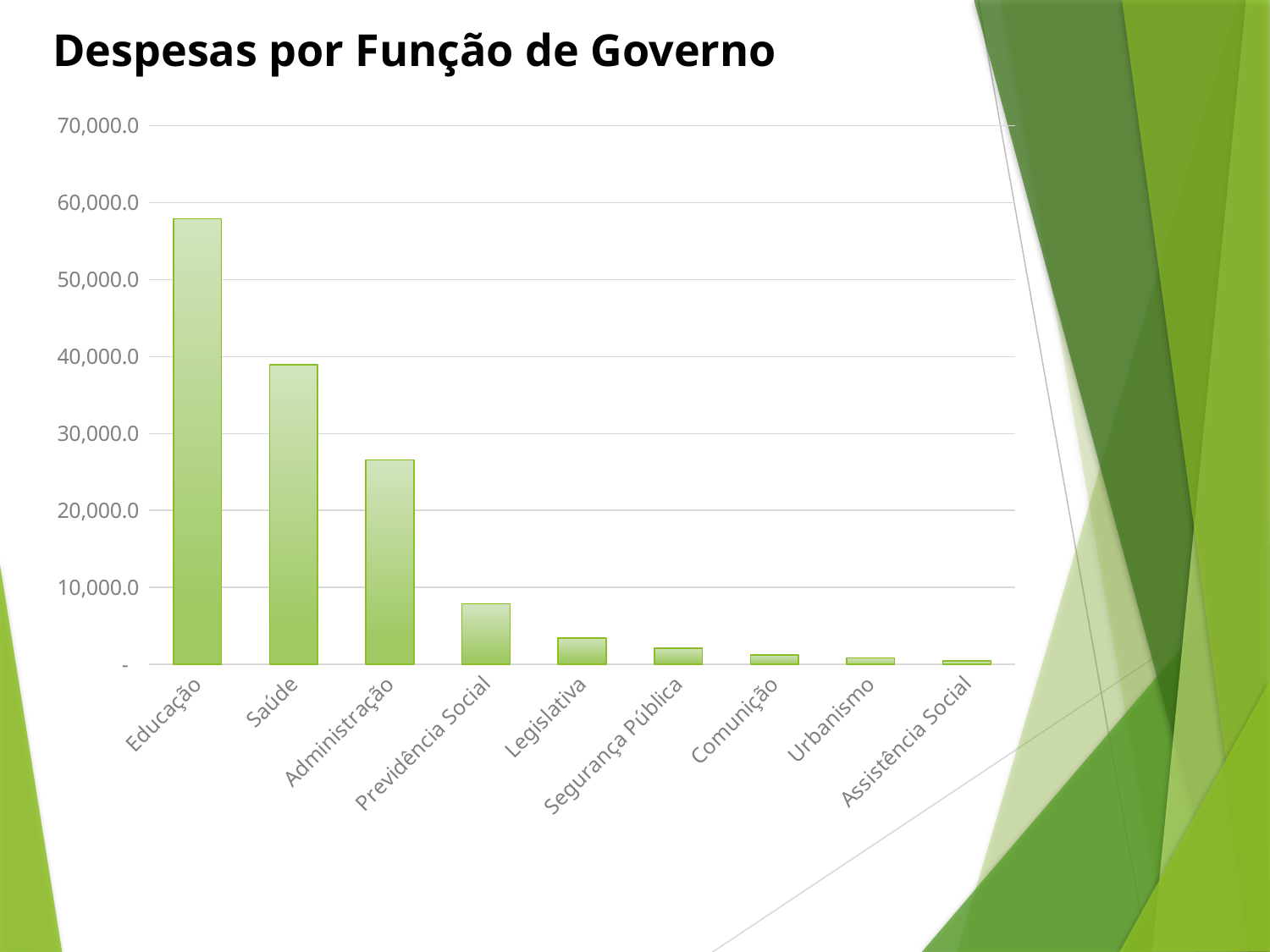
How many categories are shown on the x axis of the chart? 9 Is the value for Previdência Social greater or less than 10,000.0? less Is the value for Saúde greater or less than 30,000.0? greater Which category has the highest value in the chart? Educação What kind of chart is shown on the slide? bar chart Which category has the lowest value in the chart? Assistência Social Is the value for Administração greater or less than 30,000.0? less Do the values rise or fall moving from left to right along the x axis? fall Which is larger, the value for Saúde or the value for Administração? Saúde Which is larger, the value for Legislativa or the value for Urbanismo? Legislativa What is the title of the chart? Despesas por Função de Governo